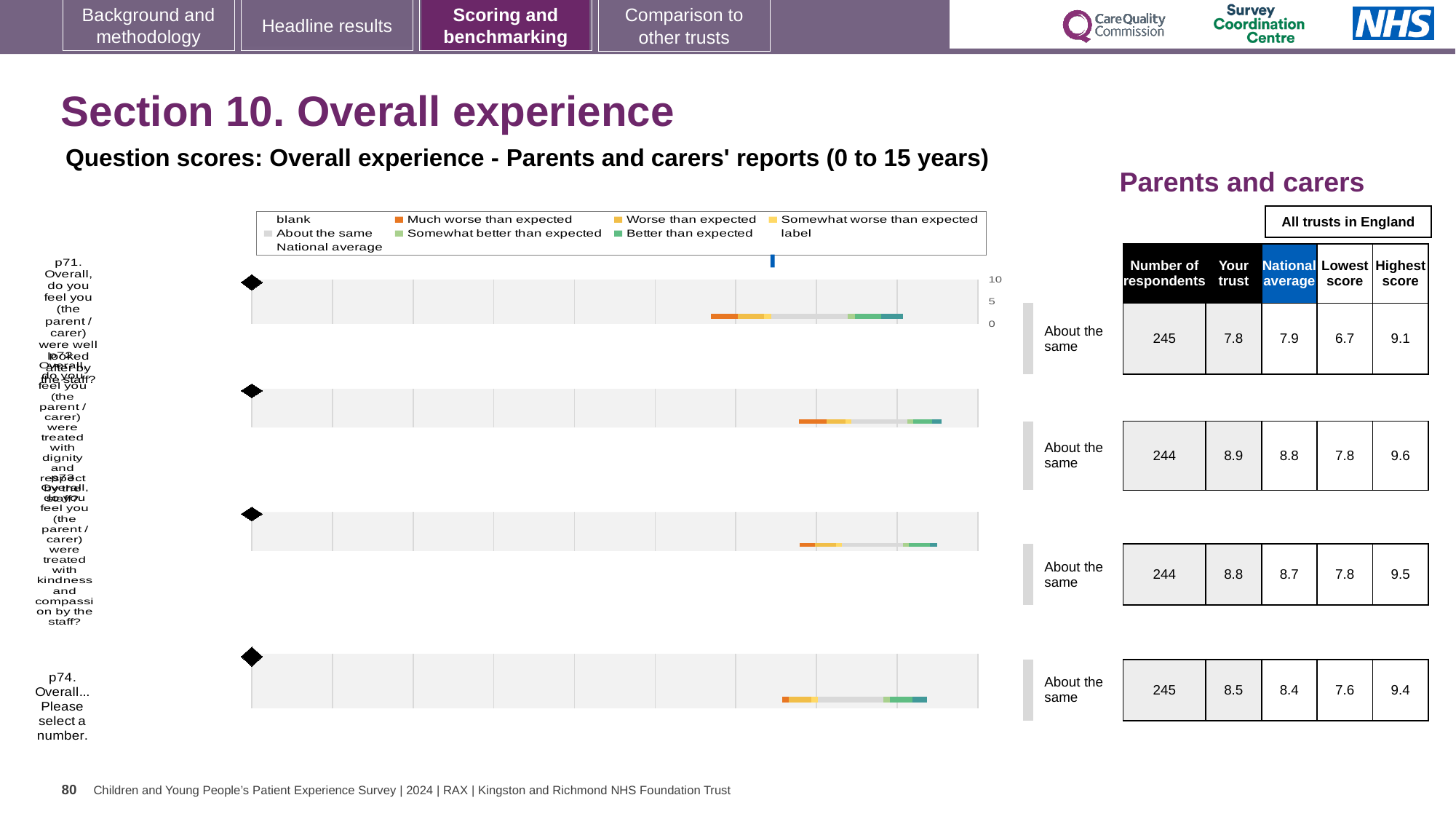
In the table next to the chart, what is the number of respondents for p74? 245 For p72, what is the difference between the 'Your trust' score and the National average? 0.1 Which question has the highest 'Your trust' score in the table? p72 What benchmark category is shown for p71? About the same In the table next to the chart, what is the National average for p72? 8.8 Which question has the lowest 'Your trust' score in the table? p71 What kind of chart is used to show the question scores on this slide? bar chart What is the heading above the chart? Question scores: Overall experience - Parents and carers' reports (0 to 15 years) In the table next to the chart, what is the 'Your trust' score for p71? 7.8 How many questions (rows) are plotted in the chart? 4 In the table next to the chart, what is the Highest score for p74? 9.4 What colour does the legend use for 'Much worse than expected'? orange